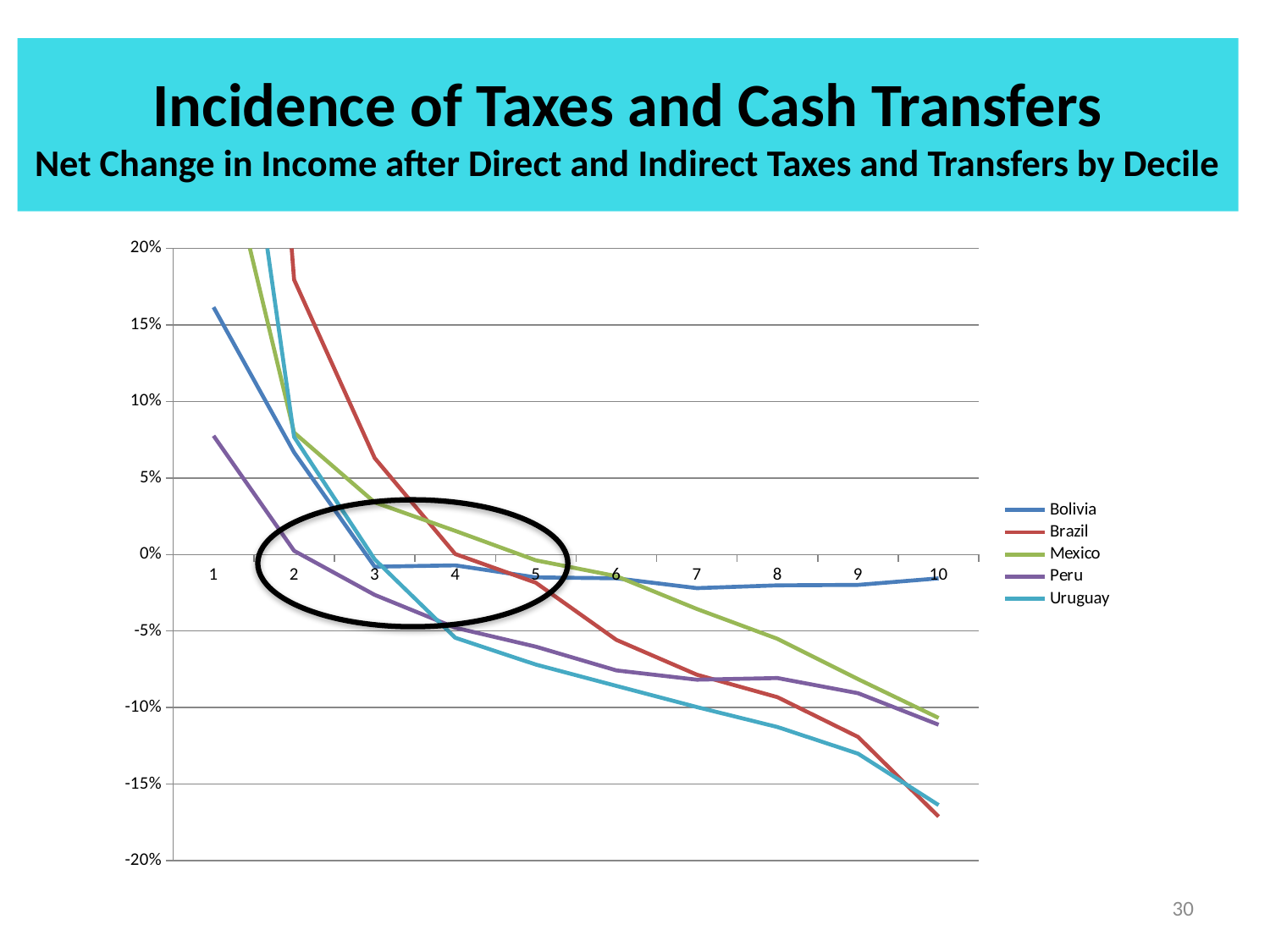
At decile 10, which series has the highest value? Bolivia What kind of chart is shown on the slide? line chart Is the value for Peru at decile 1 greater or less than 5%? greater What is the subtitle of the chart on the slide? Net Change in Income after Direct and Indirect Taxes and Transfers by Decile How many series does the legend list? 5 Do the values for Brazil rise or fall as the decile increases from 1 to 10? fall How many deciles are shown along the x axis? 10 Is the value for Brazil at decile 10 greater or less than -15%? less Is the value for Bolivia at decile 1 greater or less than 10%? greater At decile 7, which is larger, the value for Mexico or the value for Uruguay? Mexico Which countries are listed in the legend? Bolivia, Brazil, Mexico, Peru, Uruguay